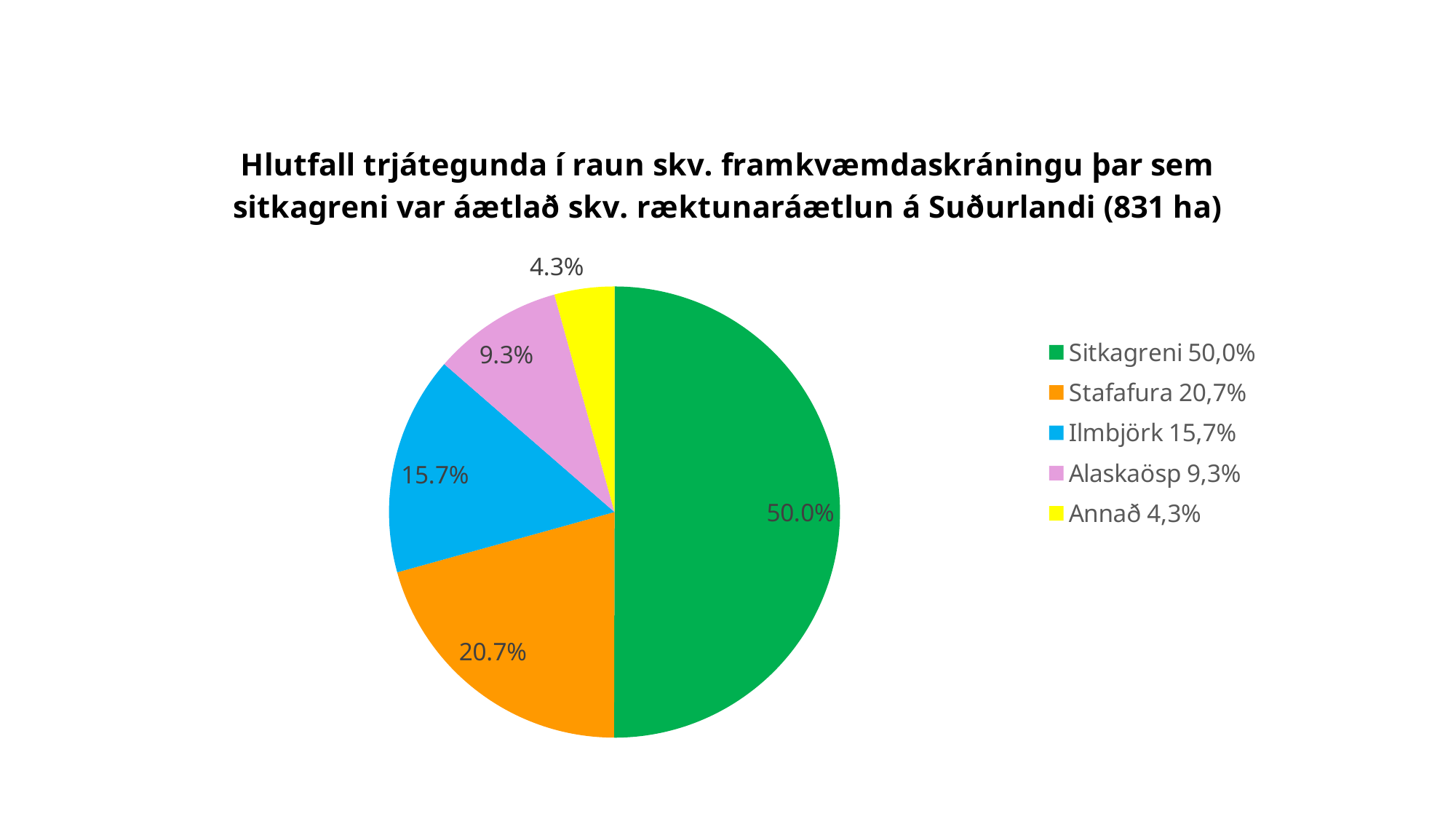
What is the value shown for Annað? 4.3% What is the value shown for Stafafura? 20.7% Which category has the smallest slice of the pie? Annað Which is larger, the share for Alaskaösp or the share for Annað? Alaskaösp Which category has the largest slice of the pie? Sitkagreni What is the value shown for Alaskaösp? 9.3% How many categories are shown in the pie chart? 5 What type of chart is shown on the slide? pie chart What is the value shown for Ilmbjörk? 15.7% What is the difference between the shares of Stafafura and Ilmbjörk? 5.0% What colour is the slice for Ilmbjörk? blue What share of the pie does Sitkagreni represent? 50.0%